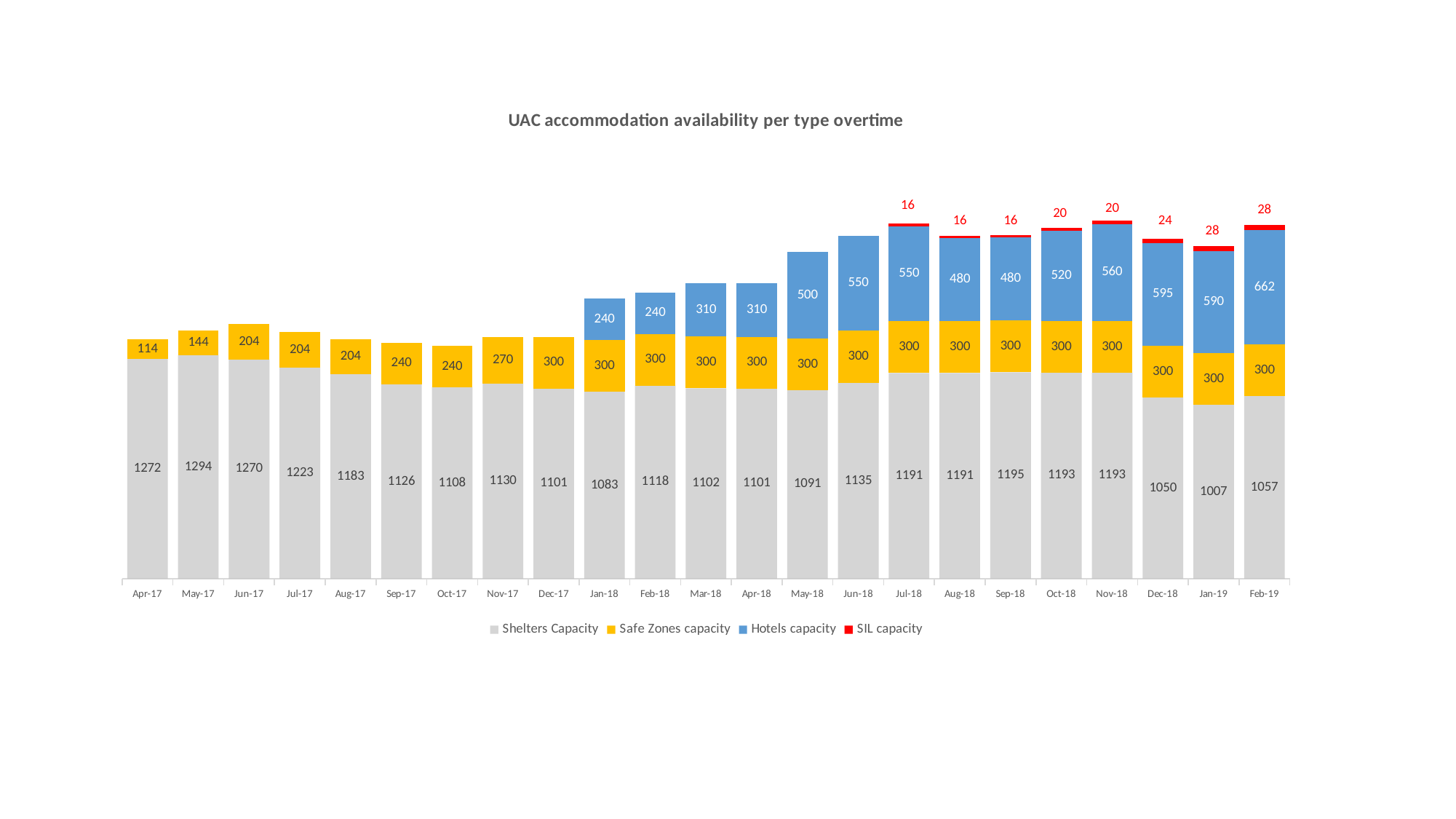
What is the SIL capacity value for Dec-18? 24 What is the Shelters Capacity value for May-17? 1294 What is the total of the stacked bar for Feb-19? 2047 Which month has the lowest Shelters Capacity? Jan-19 What is the Hotels capacity value for Feb-19? 662 Which is larger, the Shelters Capacity in Apr-17 or in Feb-19? Apr-17 What is the Safe Zones capacity value for Apr-17? 114 Which month has the highest Hotels capacity? Feb-19 How many months are shown on the x axis? 23 What is the difference between the Hotels capacity in Feb-19 and in Jan-19? 72 How many series does the legend list? 4 What type of chart is shown on the slide? Stacked bar chart